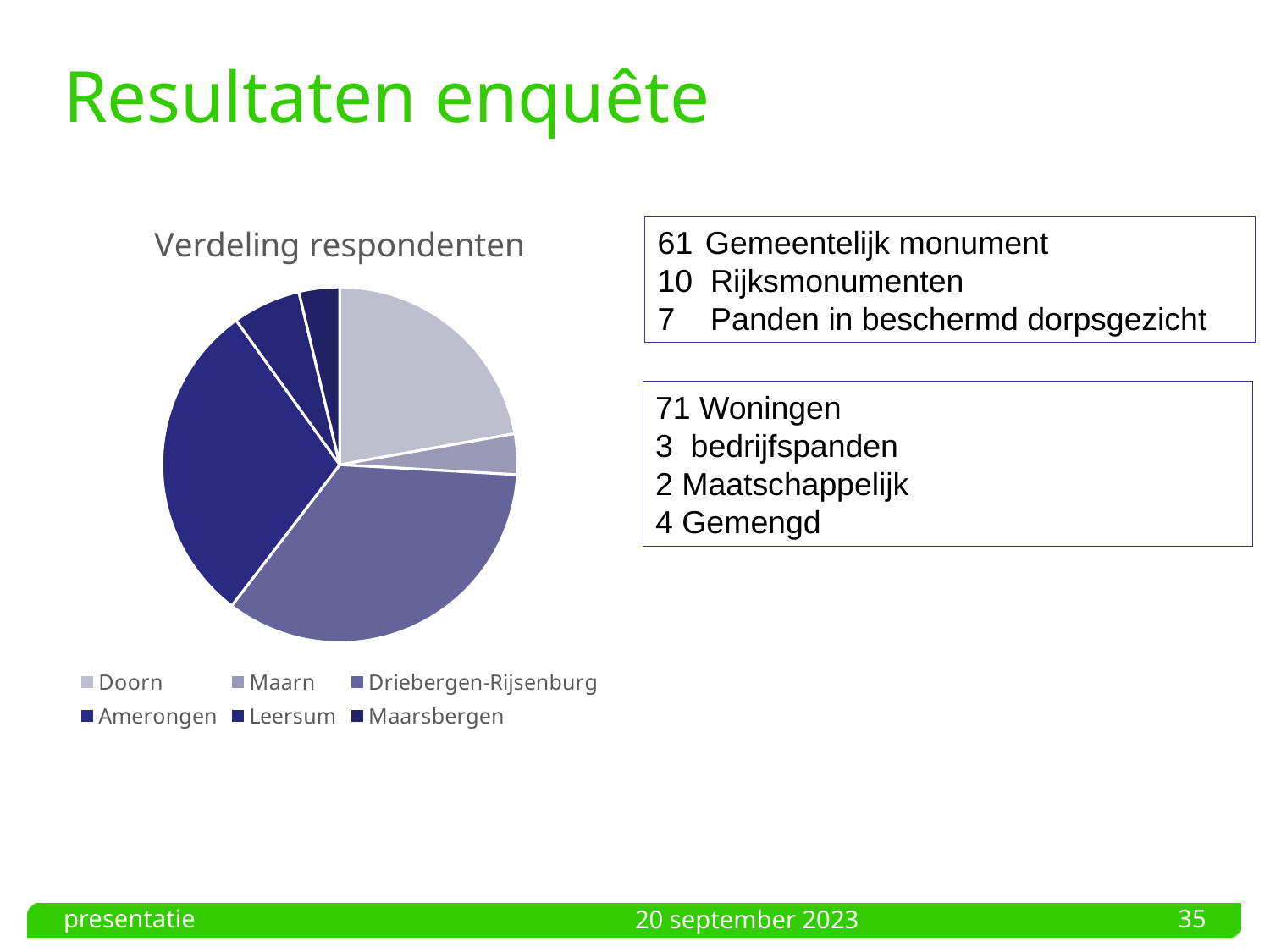
What kind of chart is shown on the slide? pie chart What is the title of the chart on the slide? Verdeling respondenten Which category is listed first in the pie chart's legend? Doorn Which slice is larger in the pie chart, Amerongen or Maarsbergen? Amerongen Which slice is larger in the pie chart, Doorn or Maarn? Doorn Which slice is larger in the pie chart, Driebergen-Rijsenburg or Maarn? Driebergen-Rijsenburg How many categories does the pie chart's legend list? 6 Which category has the largest slice in the pie chart? Driebergen-Rijsenburg